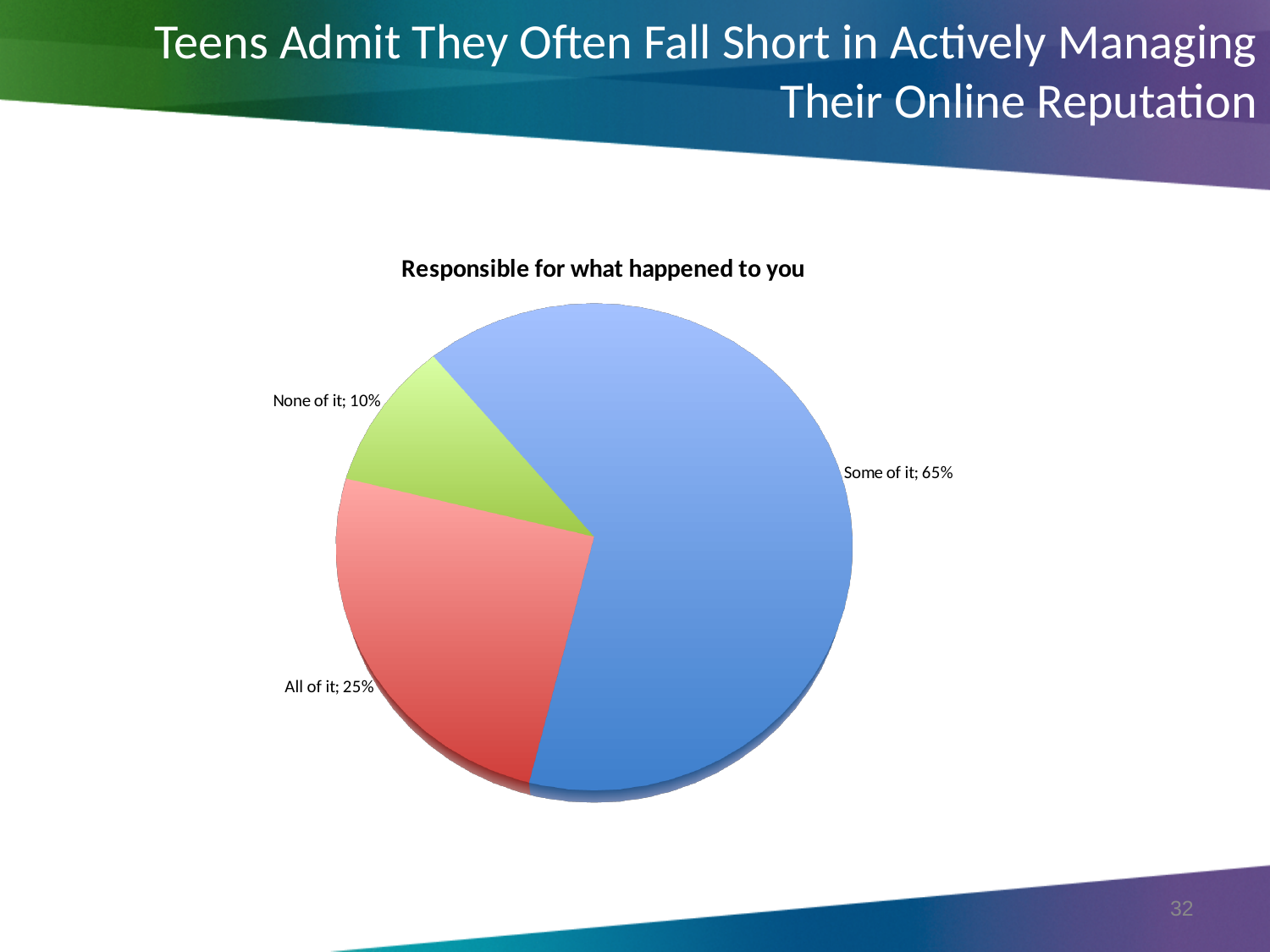
Which slice of the pie is the smallest? None of it How many slices does the pie chart have? 3 What percentage of the pie is labelled "Some of it"? 65% What colour is the "Some of it" slice? blue What is the chart's title? Responsible for what happened to you What is the difference between the "Some of it" and "All of it" shares? 40% Which slice of the pie is the largest? Some of it Which is larger, the "All of it" slice or the "None of it" slice? All of it What kind of chart is shown on the slide? pie chart What percentage of the pie is labelled "None of it"? 10% What is the difference between the "All of it" and "None of it" shares? 15% What percentage of the pie is labelled "All of it"? 25%